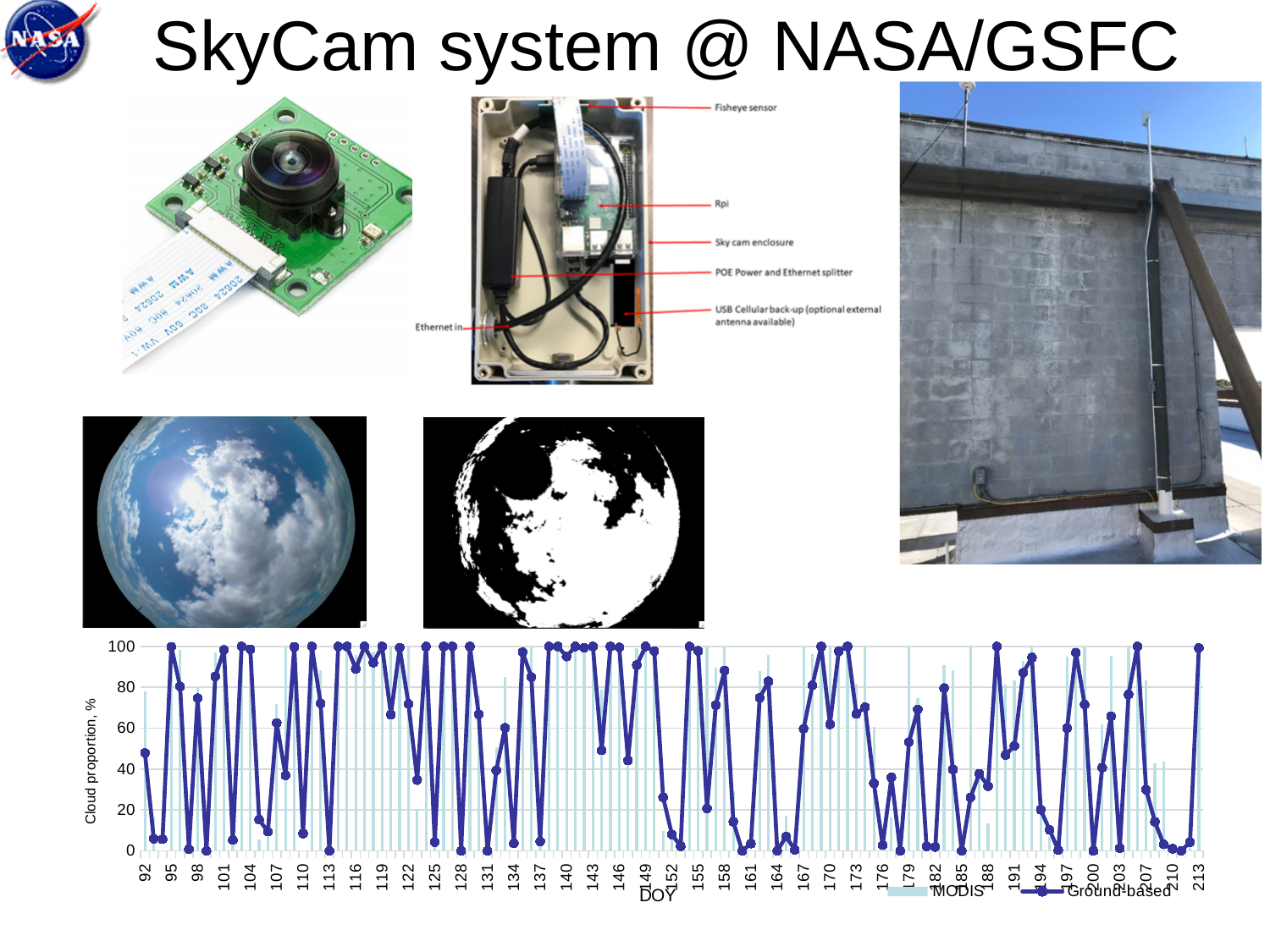
What are the two series named in the legend of the cloud proportion chart? MODIS and Ground-based What is the last DOY label on the x axis of the cloud proportion chart? 213 What is the highest value shown on the y axis of the cloud proportion chart? 100 What kind of chart is shown at the bottom of the slide? A combination of a bar chart and a line chart In the cloud proportion chart, is the Ground-based value at DOY 113 greater or less than 20? less Which series in the cloud proportion chart is drawn as a line with markers? Ground-based In the cloud proportion chart, is the Ground-based value at DOY 176 greater or less than 20? less In the cloud proportion chart, is the Ground-based value at DOY 213 greater or less than 80? greater What is the label of the y axis of the chart at the bottom of the slide? Cloud proportion, % What is the first DOY label on the x axis of the cloud proportion chart? 92 How many series does the legend of the cloud proportion chart list? 2